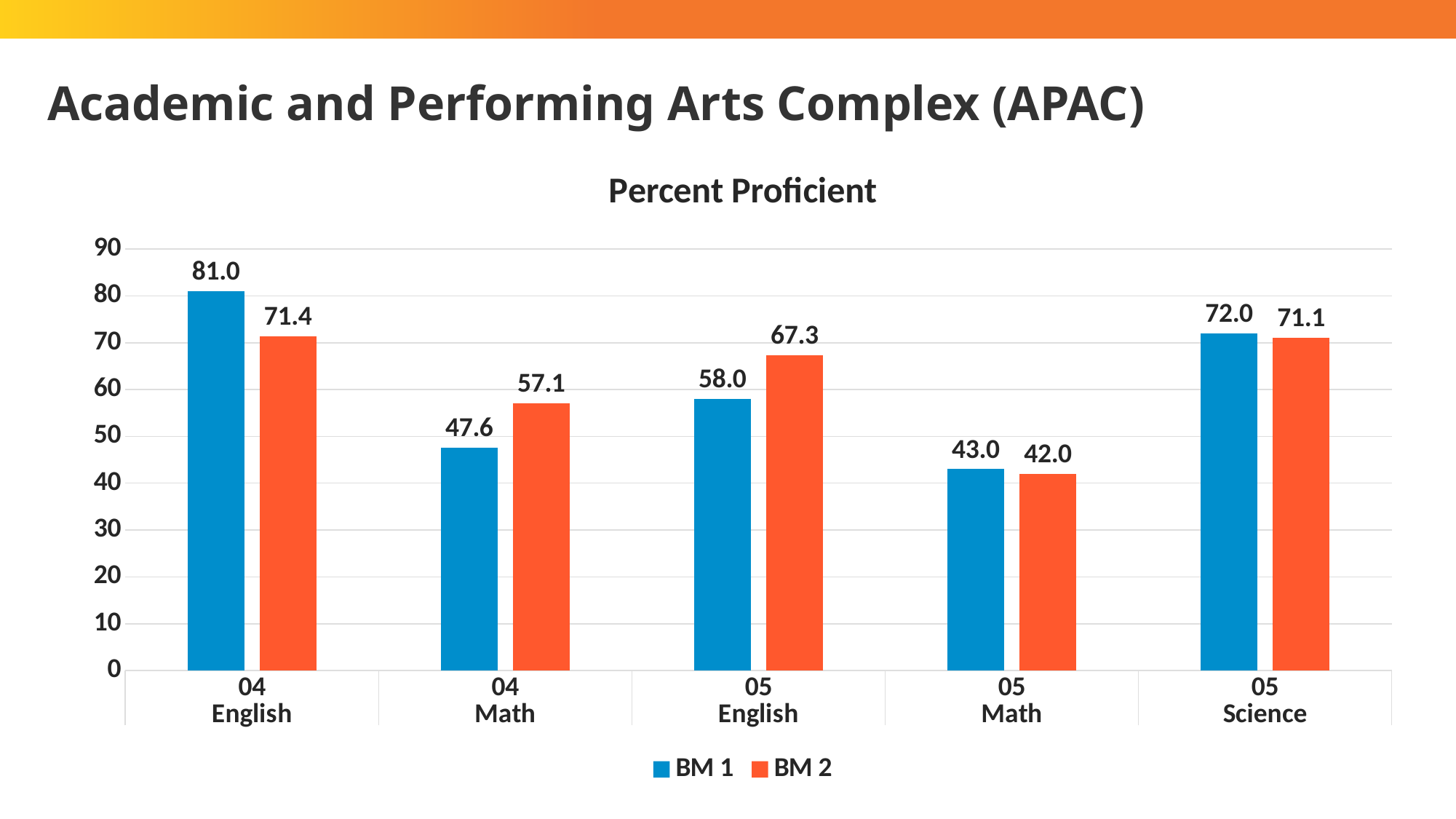
What is the difference between the BM 1 and BM 2 values for 04 English? 9.6 What is the title of the chart? Percent Proficient What is the BM 2 value for 04 Math? 57.1 How many series does the legend list? 2 Which category has the highest BM 1 value? 04 English For 04 Math, which is larger, BM 1 or BM 2? BM 2 Which category has the lowest BM 2 value? 05 Math What kind of chart is shown on the slide? Bar chart What is the BM 1 value for 04 English? 81.0 What is the difference between the BM 2 and BM 1 values for 05 English? 9.3 What is the BM 2 value for 05 English? 67.3 How many categories are shown on the x axis? 5